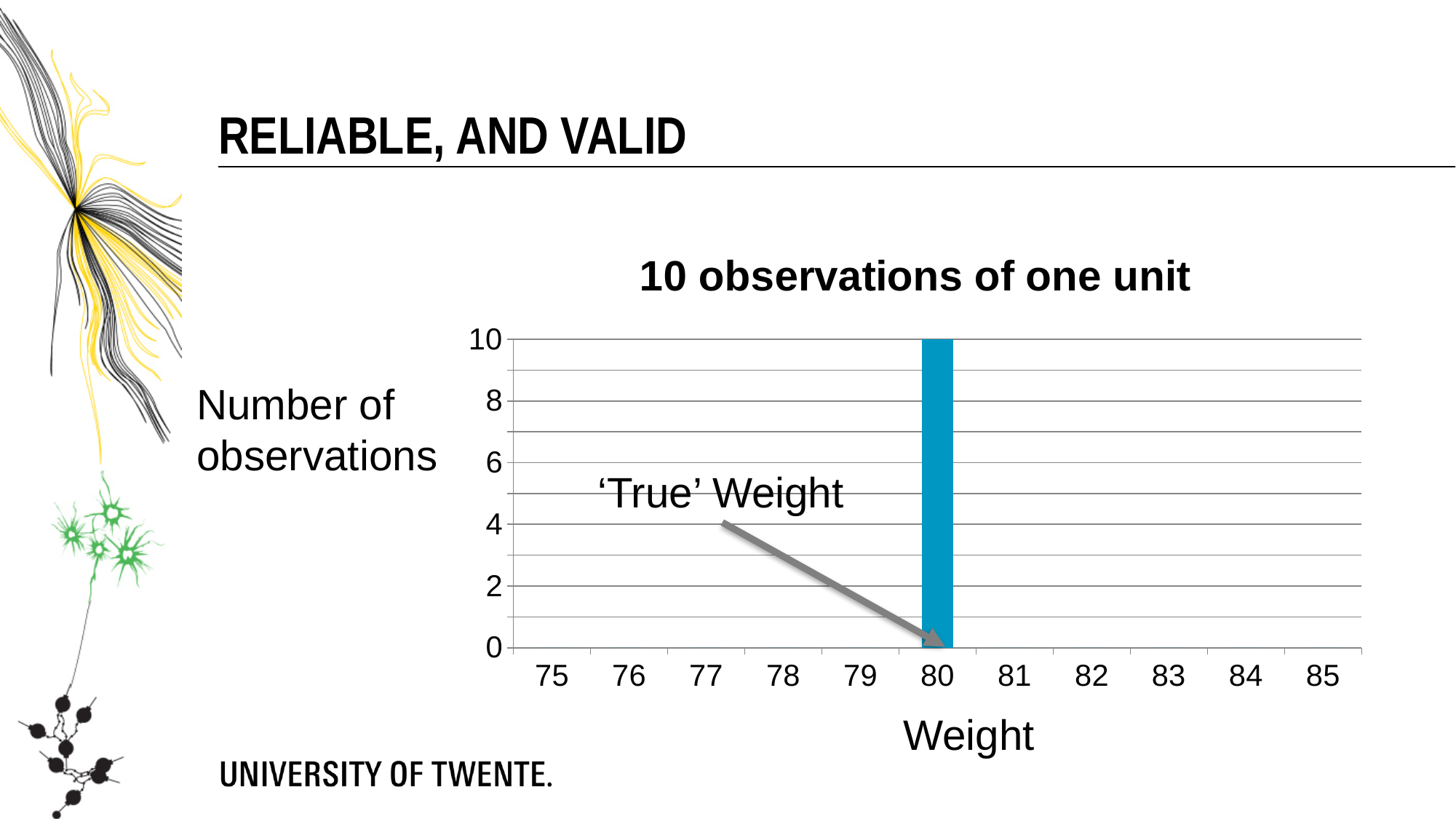
Is the number of observations at weight 84 greater or less than 4? less What kind of chart is shown on the slide? bar chart Which weight value has the highest number of observations? 80 Which has more observations, weight 80 or weight 82? 80 What label does the arrow on the chart point to the bar with? 'True' Weight How many weight categories are labelled on the x axis? 11 What is the title of the chart? 10 observations of one unit How many observations are plotted at weight 80? 10 Is the number of observations at weight 80 greater or less than 8? greater Is the number of observations at weight 78 greater or less than 2? less